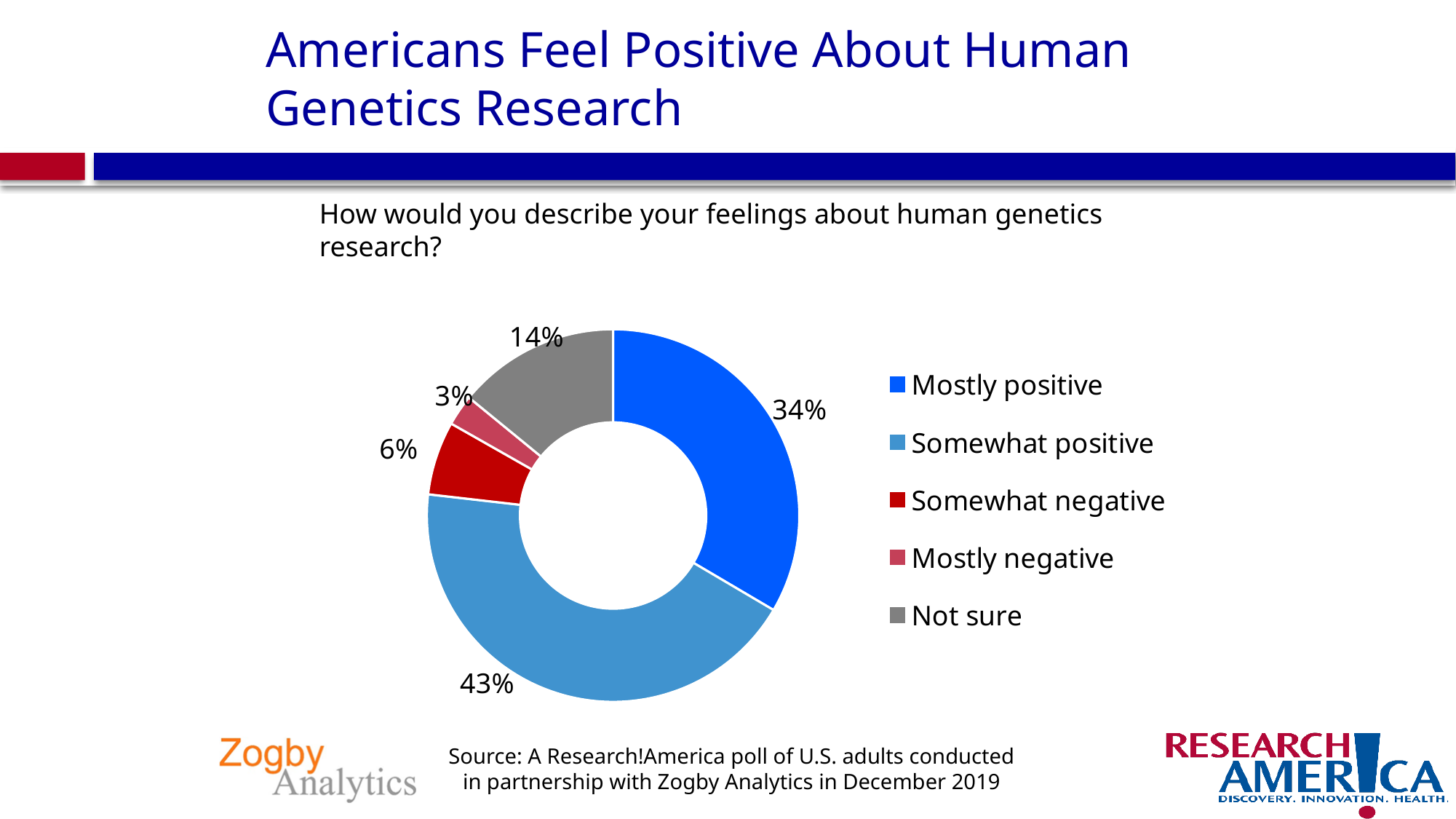
What percentage of respondents said they were not sure? 14% What is the difference in percentage points between the somewhat positive and mostly positive responses? 9 What kind of chart is shown on the slide? Pie chart (doughnut) What percentage of respondents said they feel somewhat negative? 6% Which response category has the largest share of the pie? Somewhat positive Which response category has the smallest share of the pie? Mostly negative What percentage of respondents said they feel mostly positive about human genetics research? 34% What colour represents the Not sure category in the chart? Gray Which is larger, the share for Not sure or the share for Somewhat negative? Not sure What percentage of respondents said they feel mostly negative? 3% What percentage of respondents said they feel somewhat positive? 43% How many response categories are shown in the chart? 5